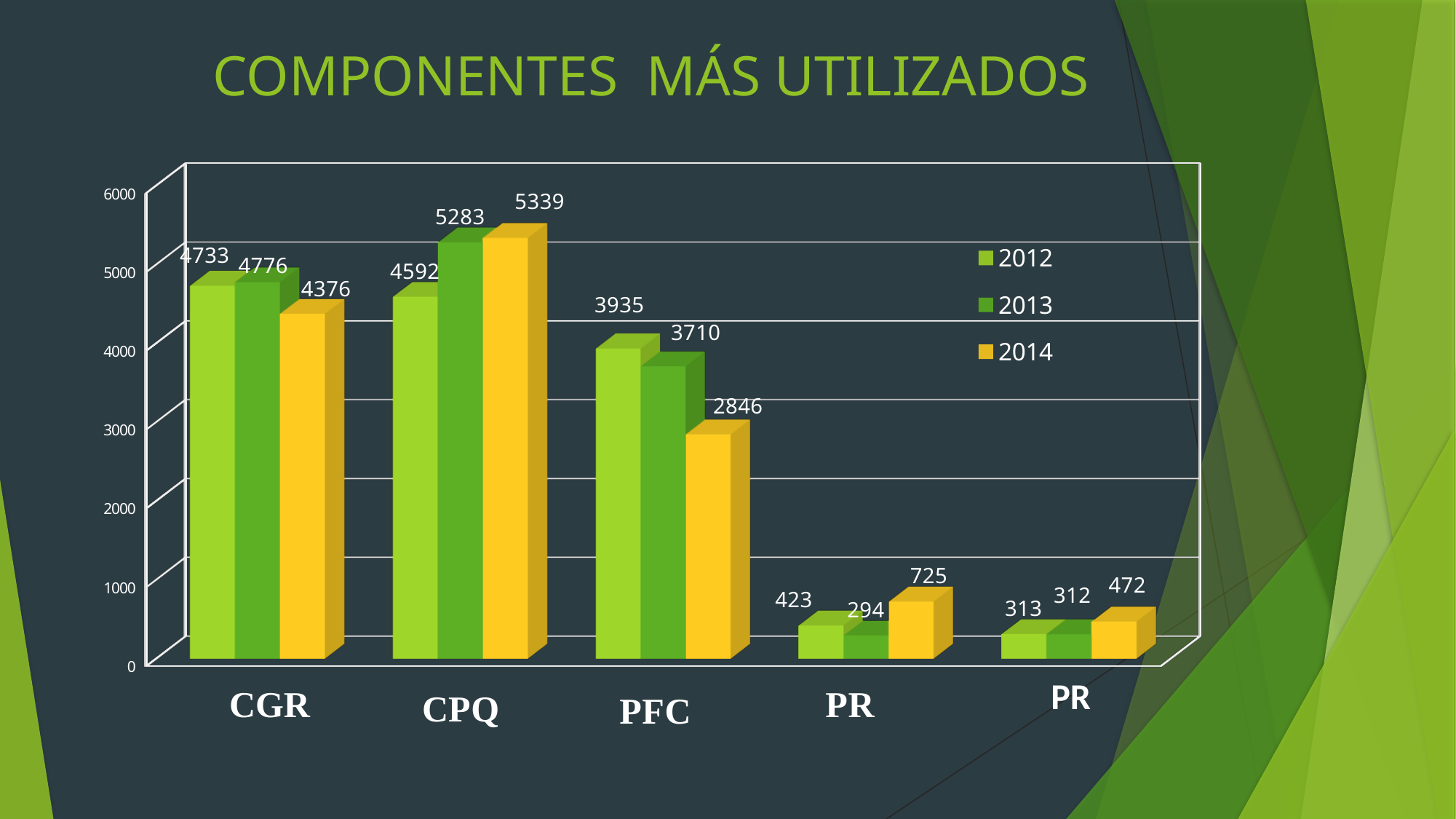
What is the title of the slide? COMPONENTES MÁS UTILIZADOS What is the value for PFC in 2012? 3935 Which category has the highest value for the 2014 series? CPQ What is the value for CPQ in 2013? 5283 How many categories are shown on the x axis? 5 Among CGR, CPQ and PFC, which has the lowest value for 2014? PFC What is the value for CGR in 2014? 4376 How many series does the legend list? 3 What is the difference between the 2012 and 2014 values for PFC? 1089 For CGR, which year has the larger value, 2012 or 2013? 2013 What is the difference between the 2014 and 2012 values for CPQ? 747 What kind of chart is shown on the slide? bar chart